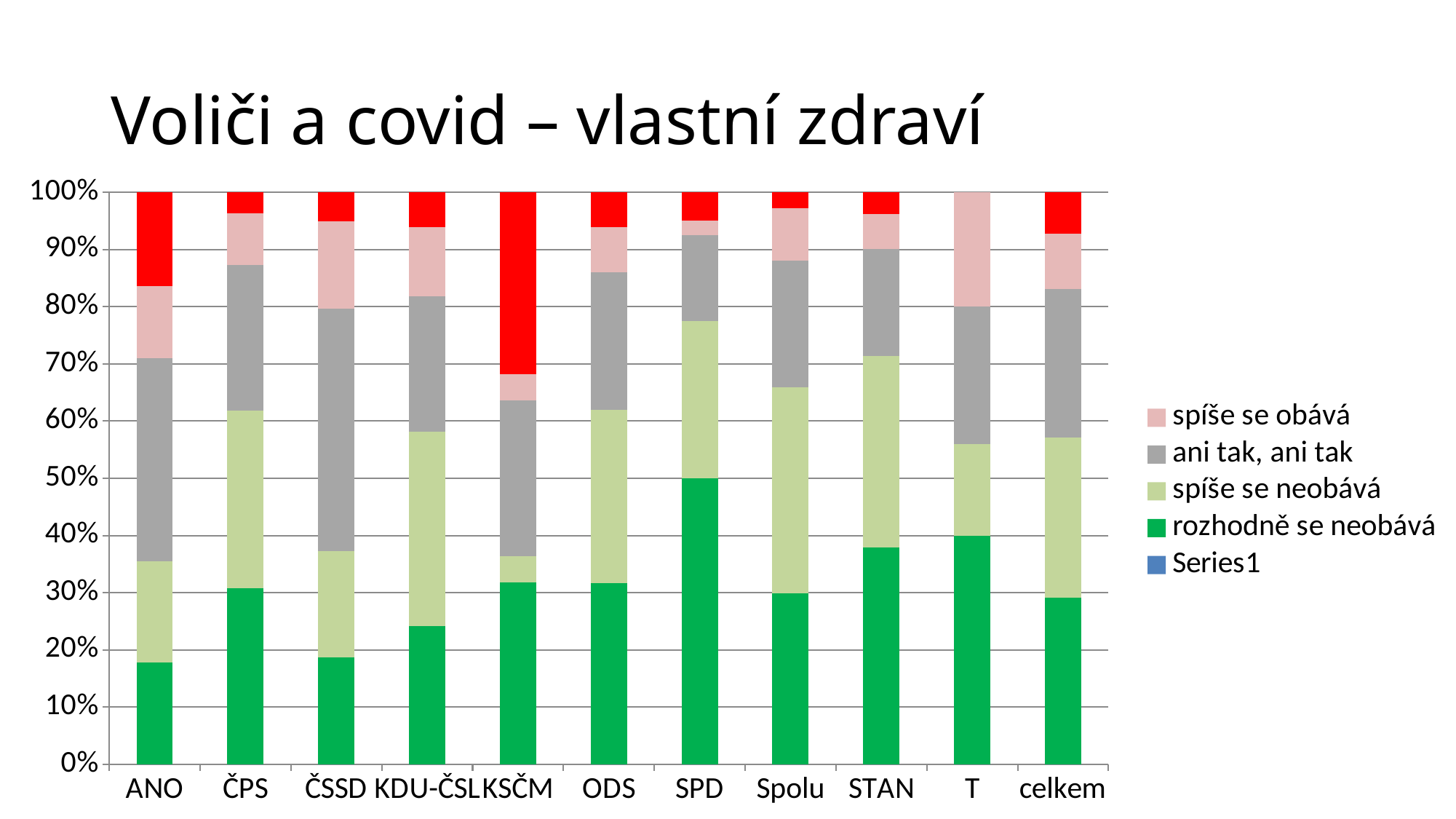
How many categories are shown on the x axis of the chart? 11 Which has a larger 'rozhodně se neobává' segment, SPD or ANO? SPD Which category has the largest 'rozhodně se neobává' segment? SPD What is the title of the chart? Voliči a covid – vlastní zdraví Is the 'rozhodně se neobává' value for ČSSD greater or less than 20%? less What kind of chart is shown on the slide? stacked bar chart How many series does the legend list? 5 Is the 'rozhodně se neobává' value for KDU-ČSL greater or less than 20%? greater Is the 'rozhodně se neobává' value for SPD greater or less than 40%? greater Which legend entry is shown in grey? ani tak, ani tak